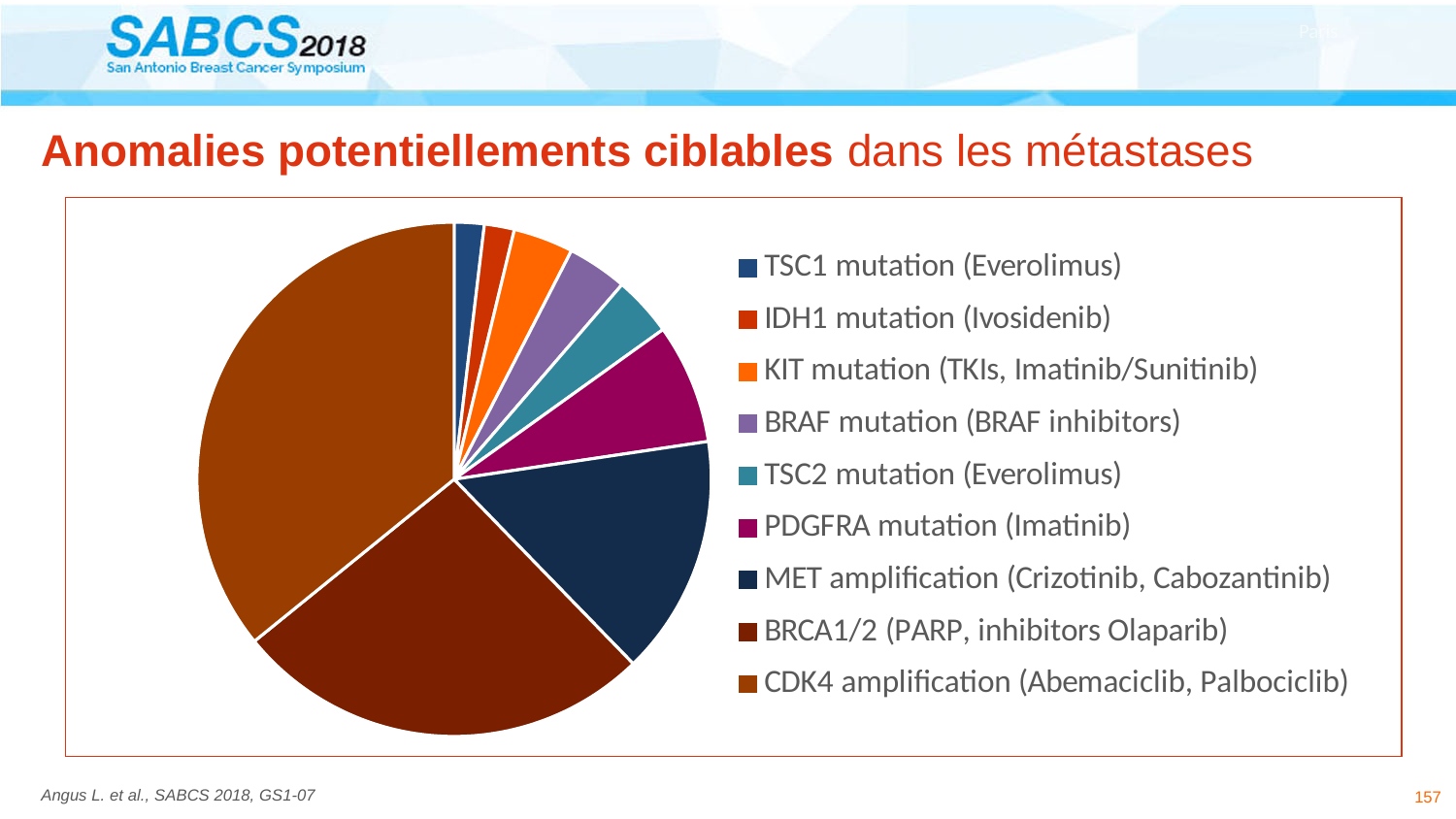
Which slice is larger: CDK4 amplification or MET amplification? CDK4 amplification Which slice is larger: KIT mutation or TSC1 mutation? KIT mutation How many entries does the legend of the pie chart list? 9 How many slices does the pie chart have? 9 Which category has the largest slice of the pie chart? CDK4 amplification (Abemaciclib, Palbociclib) Which drugs are listed in the legend for MET amplification? Crizotinib, Cabozantinib Which slice is larger: BRCA1/2 or PDGFRA mutation? BRCA1/2 Which drug is listed in the legend next to BRAF mutation? BRAF inhibitors What kind of chart is shown on the slide? pie chart